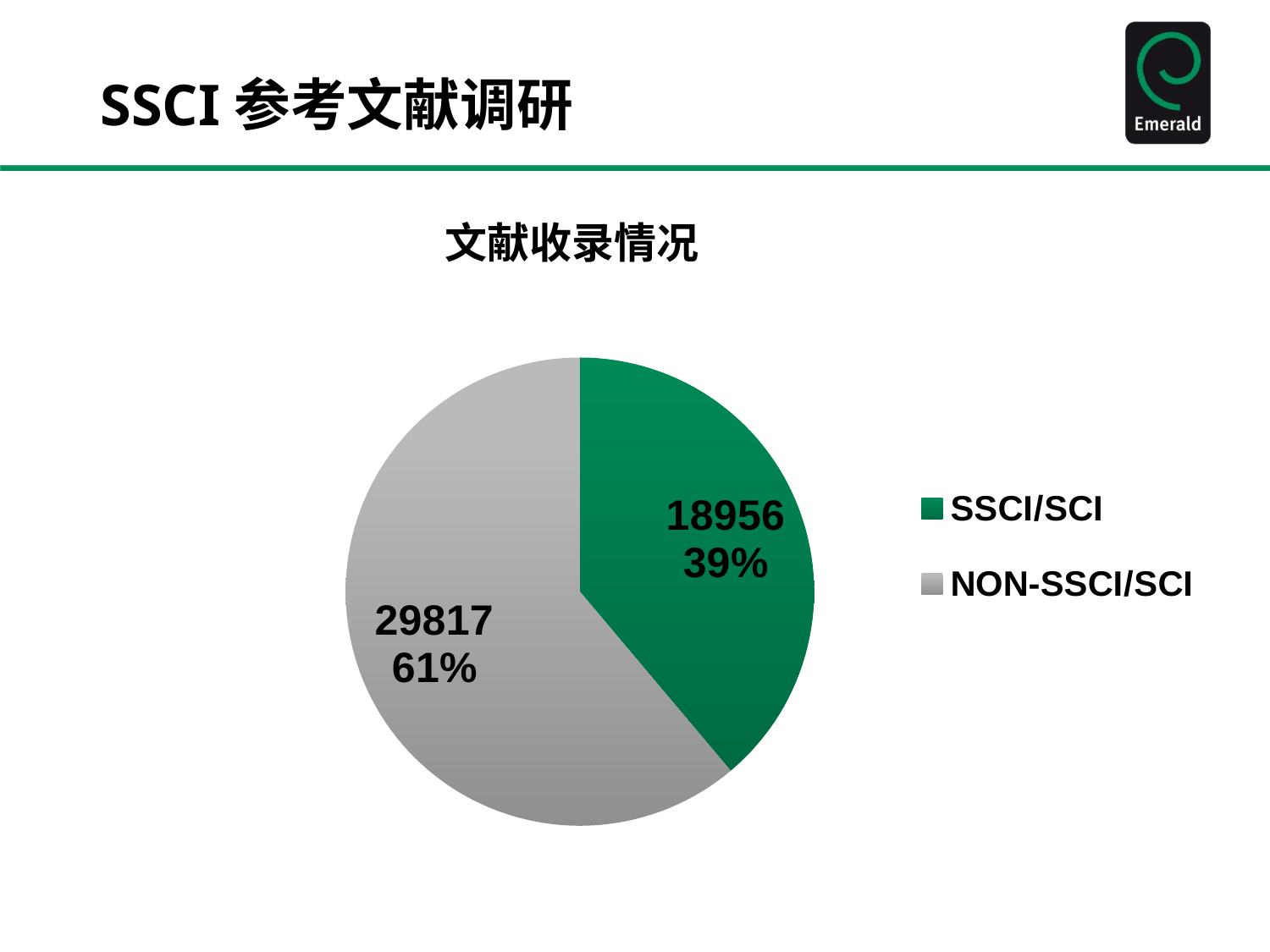
What is the value for NON-SSCI/SCI? 29817 What is the difference between the NON-SSCI/SCI value and the SSCI/SCI value? 10861 What kind of chart is shown on the slide? pie chart Which category has the largest slice? NON-SSCI/SCI What is the total of the two values shown in the pie chart? 48773 What is the value for SSCI/SCI? 18956 What colour is the SSCI/SCI slice? green Which is larger, the value for SSCI/SCI or the value for NON-SSCI/SCI? NON-SSCI/SCI What share of the pie does SSCI/SCI represent? 39% What share of the pie does NON-SSCI/SCI represent? 61% Which category has the smallest slice? SSCI/SCI How many slices does the pie chart have? 2